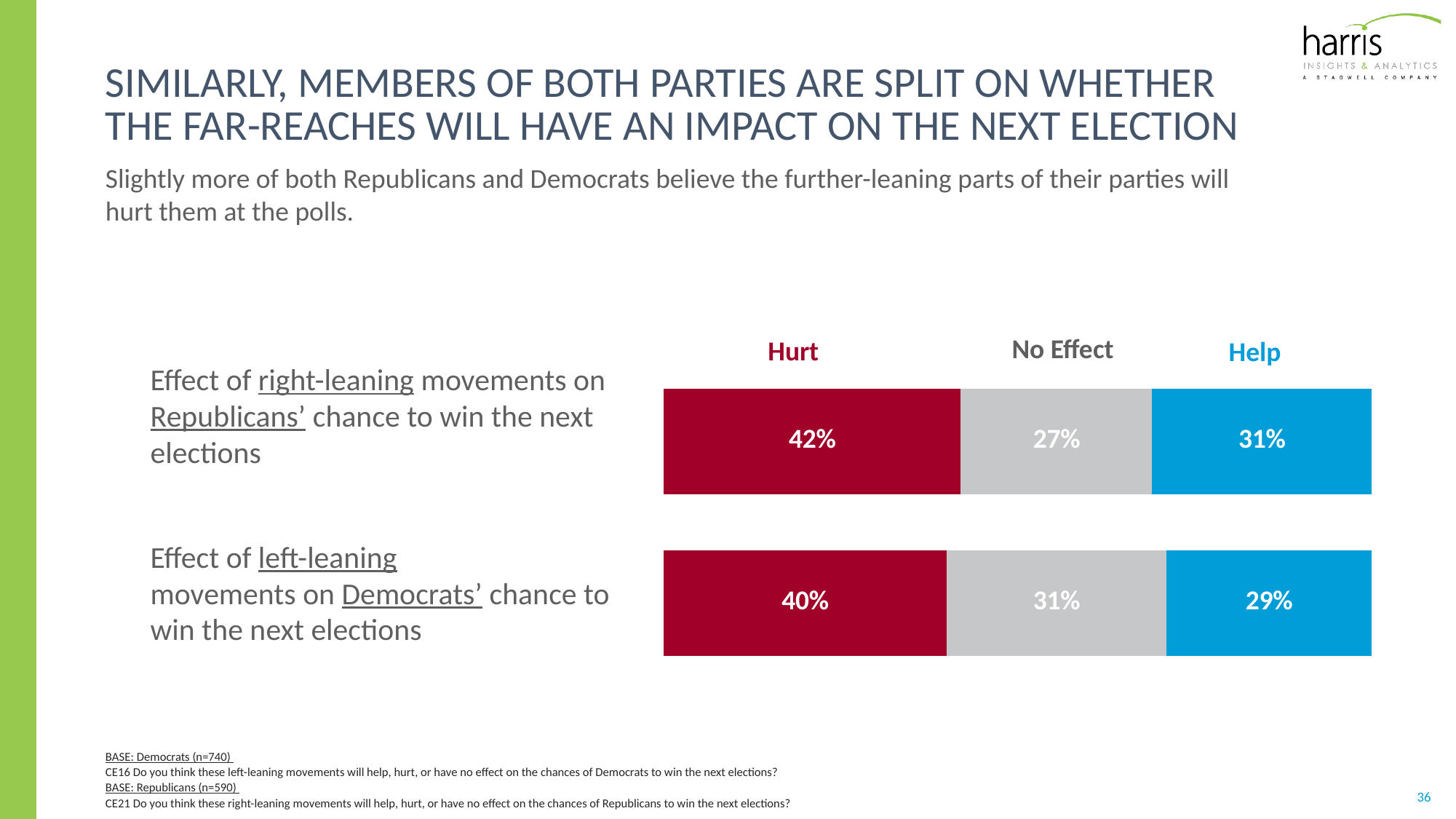
Which response is the largest for the effect of right-leaning movements on Republicans' chance to win? Hurt How many response categories are shown for each bar? 3 What percentage of Republicans say right-leaning movements will hurt Republicans' chance to win the next elections? 42% What is the difference between the Hurt and Help percentages for the effect of right-leaning movements on Republicans? 11 percentage points Which response is the smallest for the effect of left-leaning movements on Democrats' chance to win? Help What percentage of Democrats say left-leaning movements will have no effect on Democrats' chance to win the next elections? 31% Which is larger: the Hurt percentage for right-leaning movements on Republicans or the Hurt percentage for left-leaning movements on Democrats? Right-leaning movements on Republicans (42%) What type of chart is shown on the slide? Stacked bar chart What colour represents the 'Help' response in the chart? Blue What percentage of Democrats say left-leaning movements will help Democrats' chance to win the next elections? 29% What is the total of the three segments in the bar for the effect of left-leaning movements on Democrats? 100% What percentage of Republicans say right-leaning movements will have no effect on Republicans' chance to win the next elections? 27%